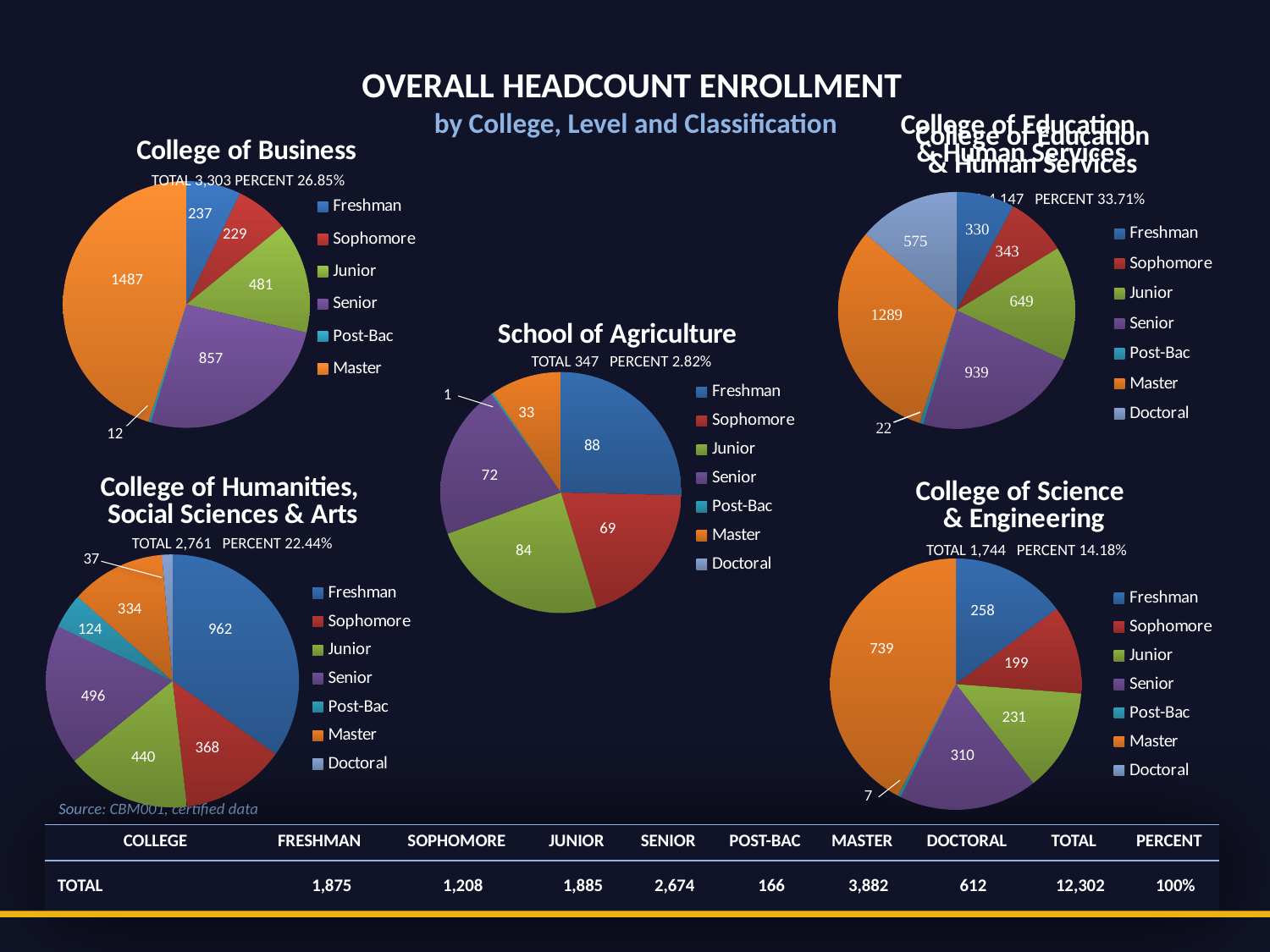
In the College of Education & Human Services chart, how many students are Doctoral? 575 In the College of Business chart, how many students are in the Master level? 1487 In the College of Humanities, Social Sciences & Arts chart, what is the Post-Bac value? 124 In the College of Humanities, Social Sciences & Arts chart, which level has the largest slice? Freshman In the College of Business chart, which level has the smallest slice? Post-Bac How many entries does the legend of the College of Science & Engineering chart list? 7 In the College of Business chart, which level has the largest slice? Master In the College of Science & Engineering chart, what is the difference between the Master and Senior values? 429 In the School of Agriculture chart, what is the difference between the Freshman and Sophomore values? 19 In the School of Agriculture chart, how many students are Freshman? 88 In the College of Education & Human Services chart, which is larger, the Junior value or the Senior value? Senior What type of chart is used for the College of Business? Pie chart